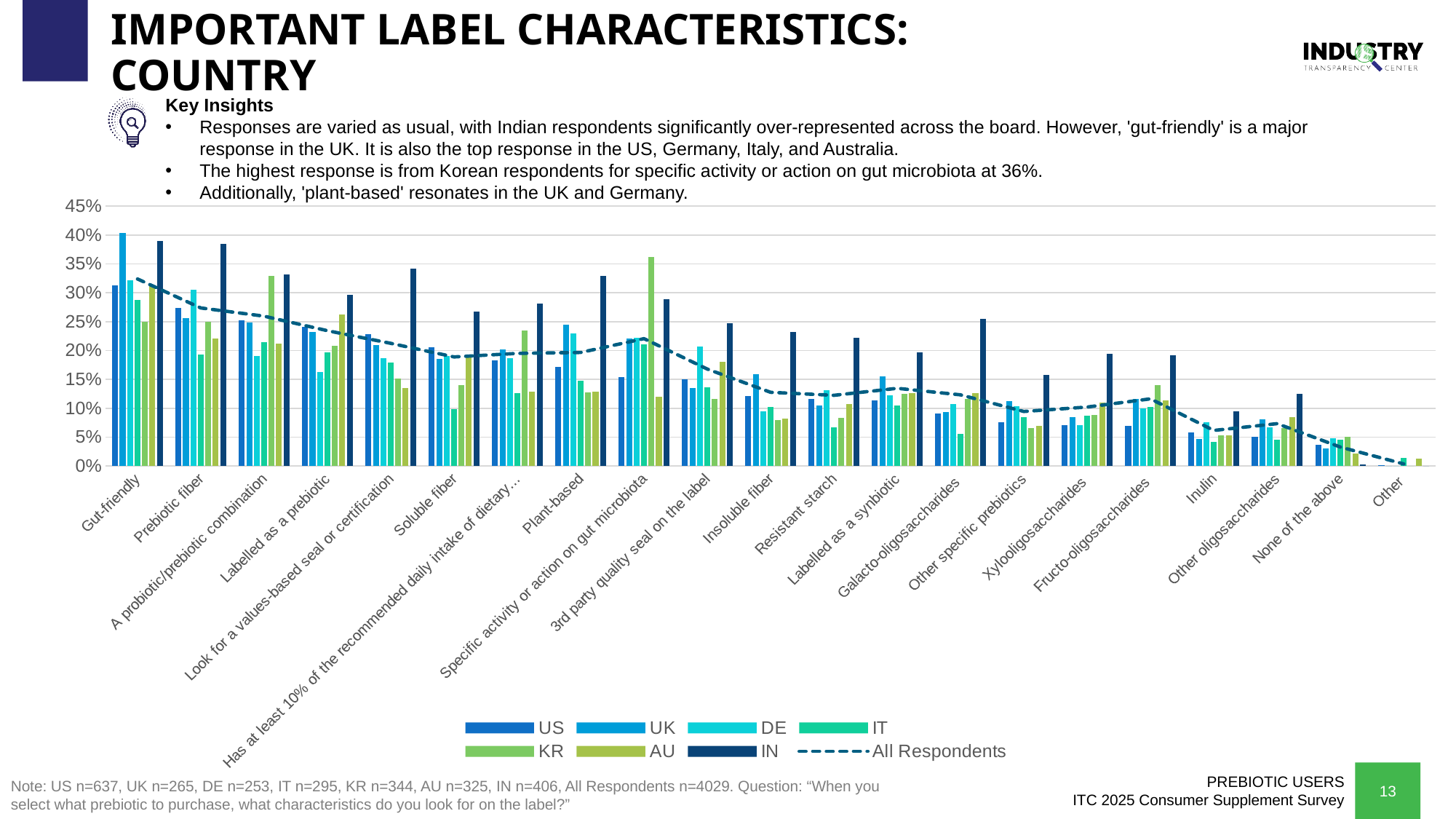
Which country has the highest bar for 'Other specific prebiotics'? IN What kind of chart is shown on the slide? Bar chart (with a dashed line for All Respondents) Is the UK value for 'Gut-friendly' greater or less than 35%? greater Is the IN value for 'Inulin' greater or less than 15%? less Does the dashed 'All Respondents' line generally rise or fall from left to right across the categories? Fall For 'Plant-based', which is larger: the IN value or the US value? IN Which country has the highest bar for 'Specific activity or action on gut microbiota'? KR Which country has the lowest bar for 'Gut-friendly'? KR Is the KR value for 'Specific activity or action on gut microbiota' greater or less than 30%? greater How many label characteristic categories are shown along the x axis? 21 How many series does the chart legend list? 8